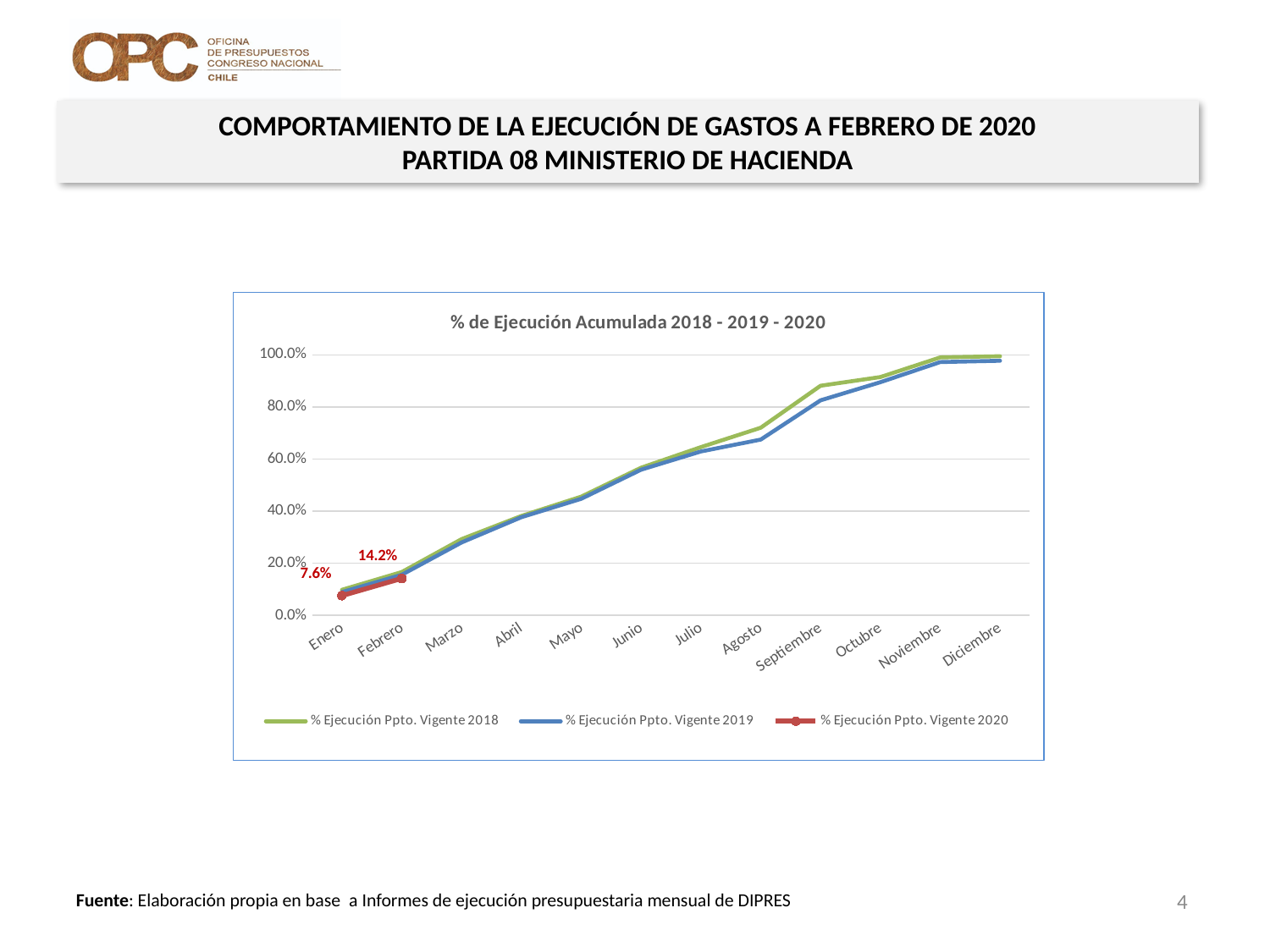
What is the title of the chart? % de Ejecución Acumulada 2018 - 2019 - 2020 Is the value for % Ejecución Ppto. Vigente 2018 in Septiembre greater or less than 80.0%? greater What is the value of % Ejecución Ppto. Vigente 2020 for Febrero? 14.2% What is the value of % Ejecución Ppto. Vigente 2020 for Enero? 7.6% How many series does the chart legend list? 3 What kind of chart is shown on the slide? line chart Is the value for % Ejecución Ppto. Vigente 2019 in Agosto greater or less than 80.0%? less In which month does % Ejecución Ppto. Vigente 2019 reach its highest value? Diciembre In Septiembre, which series has the higher value: % Ejecución Ppto. Vigente 2018 or % Ejecución Ppto. Vigente 2019? % Ejecución Ppto. Vigente 2018 Do the values for % Ejecución Ppto. Vigente 2018 rise or fall from Enero to Diciembre? rise How many months are shown along the x axis of the chart? 12 By how much did % Ejecución Ppto. Vigente 2020 increase from Enero to Febrero? 6.6%